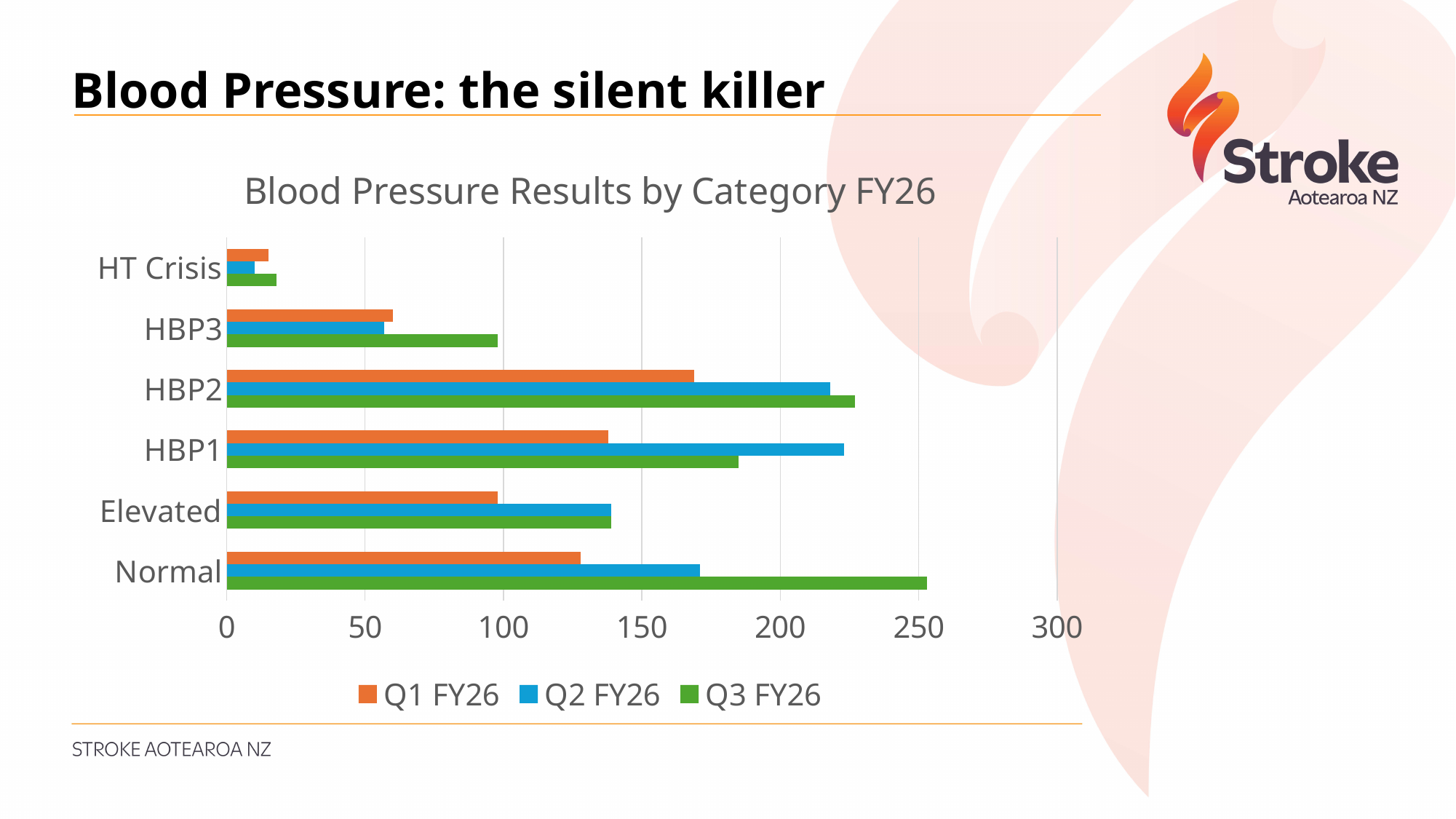
What is the title of the chart? Blood Pressure Results by Category FY26 For HBP2, which is larger: the Q1 FY26 value or the Q2 FY26 value? Q2 FY26 How many series does the legend list? 3 What kind of chart is shown on the slide? Bar chart For Normal, which is larger: the Q2 FY26 value or the Q3 FY26 value? Q3 FY26 Is the Q2 FY26 value for HBP1 greater or less than 200? greater Which category has the highest Q3 FY26 value? Normal How many blood pressure categories are plotted on the chart? 6 Which category has the lowest Q3 FY26 value? HT Crisis Is the Q1 FY26 value for Elevated greater or less than 150? less Is the Q3 FY26 value for Normal greater or less than 200? greater Which category has the lowest Q1 FY26 value? HT Crisis